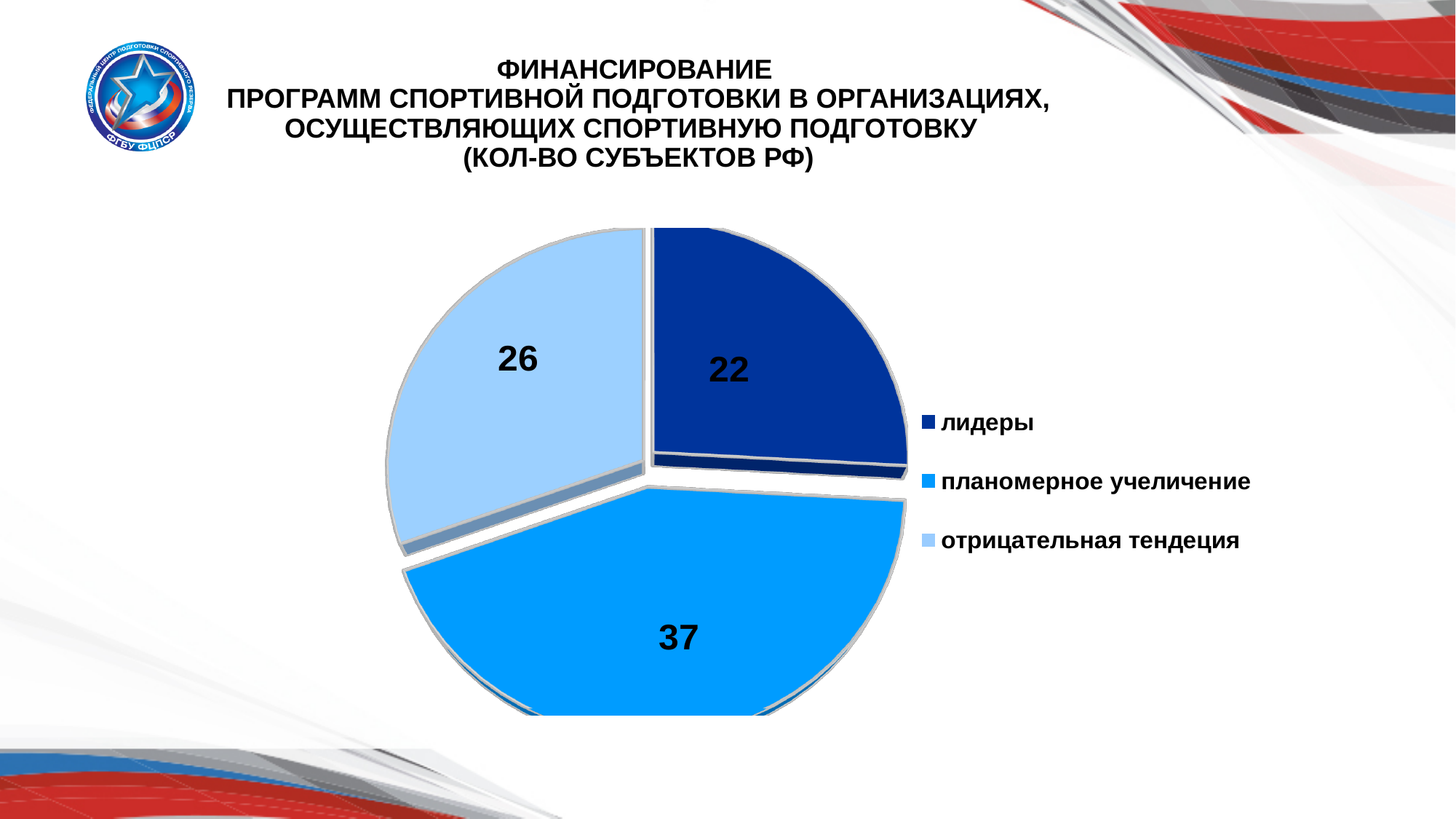
Which category has the largest slice? планомерное учеличение What is the total of all three slices in the pie chart? 85 What kind of chart is shown on the slide? pie chart What is the difference between the values for «отрицательная тендеция» and «лидеры»? 4 Which category has the smallest slice? лидеры What is the value for «отрицательная тендеция»? 26 What is the value for «планомерное учеличение»? 37 How many slices does the pie chart have? 3 Which legend entry is shown in the darkest blue colour? лидеры What is the difference between the values for «планомерное учеличение» and «лидеры»? 15 Which is larger, the value for «отрицательная тендеция» or the value for «лидеры»? отрицательная тендеция What is the value for «лидеры»? 22